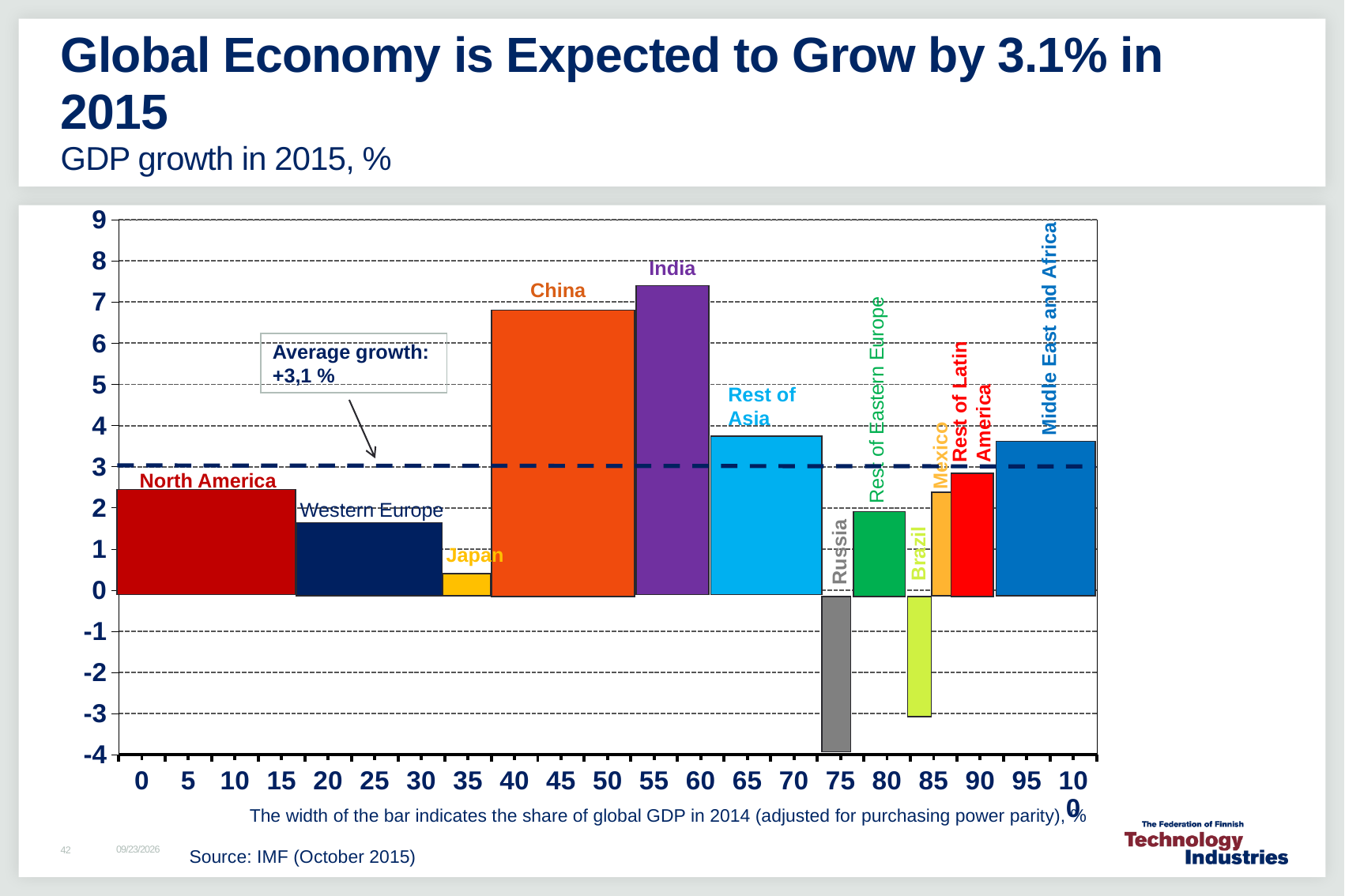
Is the GDP growth value for China greater or less than 6? greater How many regions are shown as bars on the chart? 12 Which region has the lowest GDP growth in 2015 on the chart? Russia Which has higher GDP growth in 2015, North America or Western Europe? North America Is the GDP growth value for Japan greater or less than 1? less Is the GDP growth value for Brazil greater or less than -2? less What average growth value is shown by the dashed line on the chart? +3,1 % Which region has the highest GDP growth in 2015 on the chart? India Which has higher GDP growth in 2015, China or India? India What type of chart is shown on the slide? bar chart According to the note below the chart, what does the width of each bar indicate? The share of global GDP in 2014 (adjusted for purchasing power parity), %